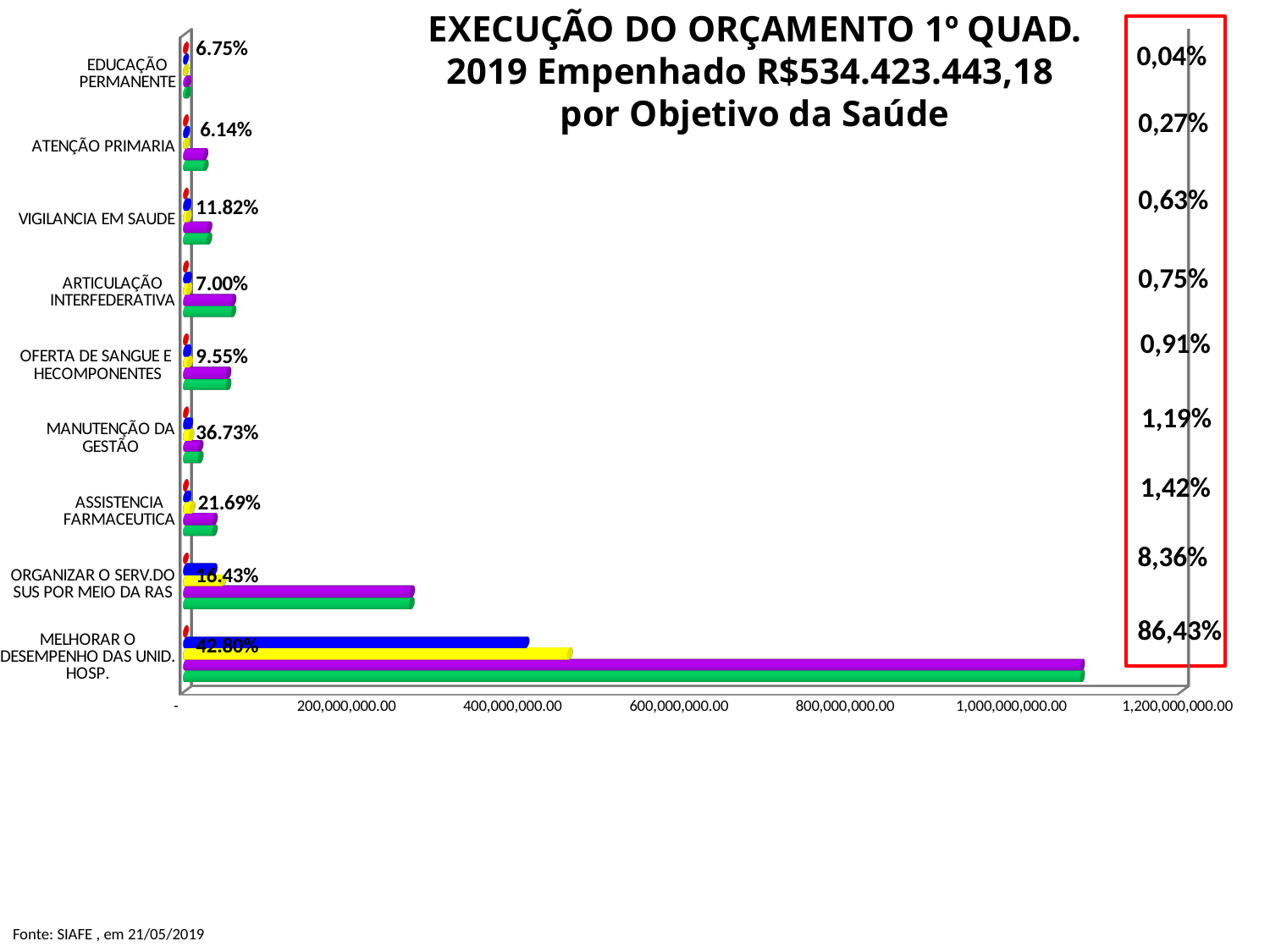
Which has the larger percentage label, VIGILANCIA EM SAUDE or ATENÇÃO PRIMARIA? VIGILANCIA EM SAUDE What kind of chart is shown on the slide? bar chart Is the purple bar for MELHORAR O DESEMPENHO DAS UNID. HOSP. greater or less than 1,000,000,000.00? greater What is the highest percentage shown in the red box on the right of the chart? 86,43% What percentage label is shown for OFERTA DE SANGUE E HECOMPONENTES? 9.55% What percentage label is shown for ASSISTENCIA FARMACEUTICA? 21.69% Which category has the longest bars in the chart? MELHORAR O DESEMPENHO DAS UNID. HOSP. What percentage label is shown for VIGILANCIA EM SAUDE? 11.82% What is the difference between the percentage labels for MANUTENÇÃO DA GESTÃO and ASSISTENCIA FARMACEUTICA? 15.04% How many categories are plotted on the vertical axis of the chart? 9 What percentage label is shown for MANUTENÇÃO DA GESTÃO? 36.73% Is the purple bar for ORGANIZAR O SERV.DO SUS POR MEIO DA RAS greater or less than 400,000,000.00? less